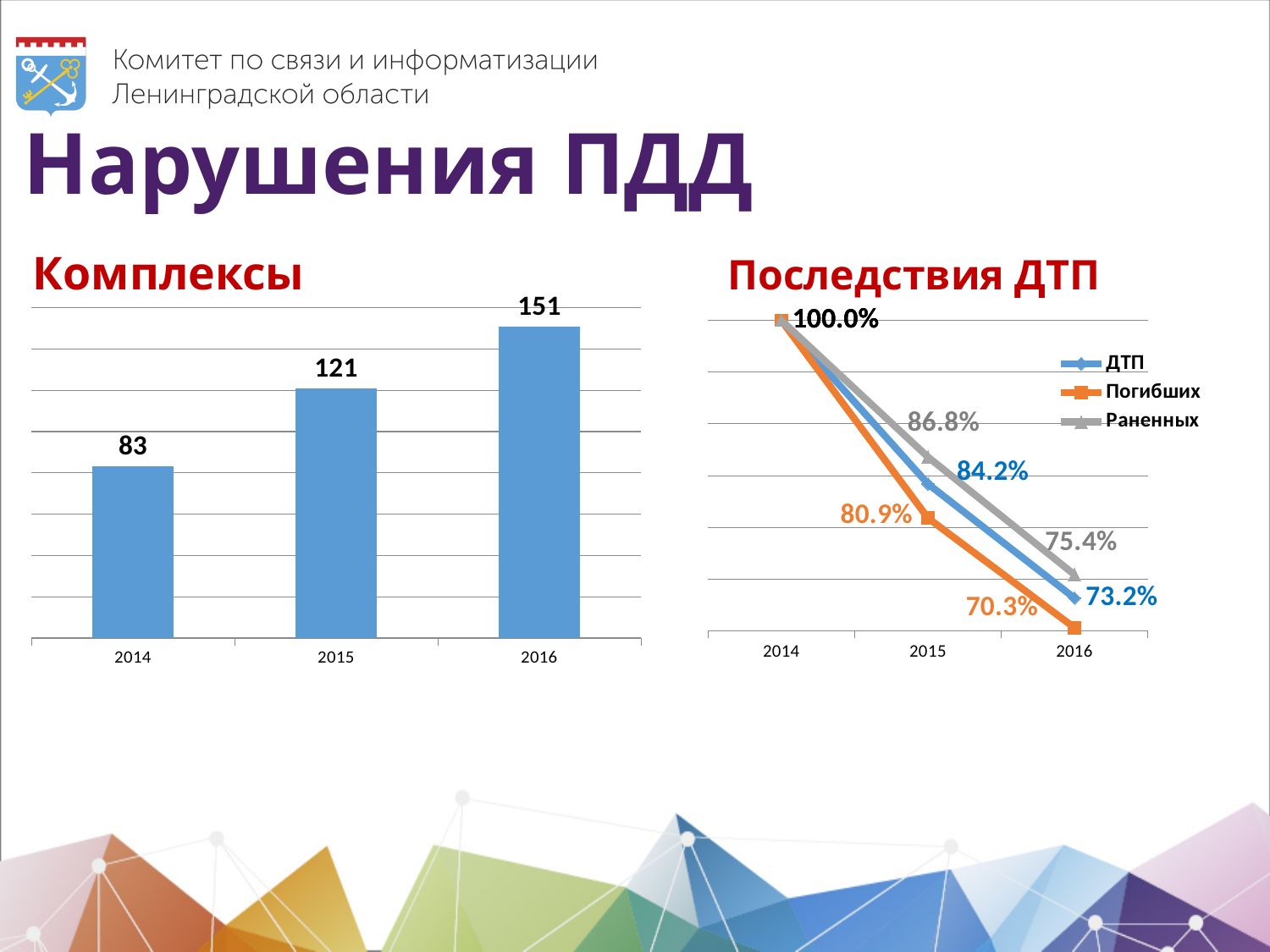
In the "Комплексы" chart, what is the value for 2014? 83 In the "Последствия ДТП" chart, what is the difference between Раненных and Погибших in 2015? 5.9% What kind of chart is the "Комплексы" chart? bar chart In the "Комплексы" chart, what is the difference between the values for 2016 and 2014? 68 In the "Последствия ДТП" chart, what is the value for Погибших in 2016? 70.3% In the "Комплексы" chart, which year has the lowest value? 2014 In the "Комплексы" chart, which year has the highest value? 2016 In the "Последствия ДТП" chart, what is the value for Раненных in 2015? 86.8% In the "Последствия ДТП" chart, how many series does the legend list? 3 In the "Комплексы" chart, do the values rise or fall from 2014 to 2016? rise In the "Комплексы" chart, what is the value for 2016? 151 In the "Последствия ДТП" chart, which is larger in 2016: ДТП or Погибших? ДТП